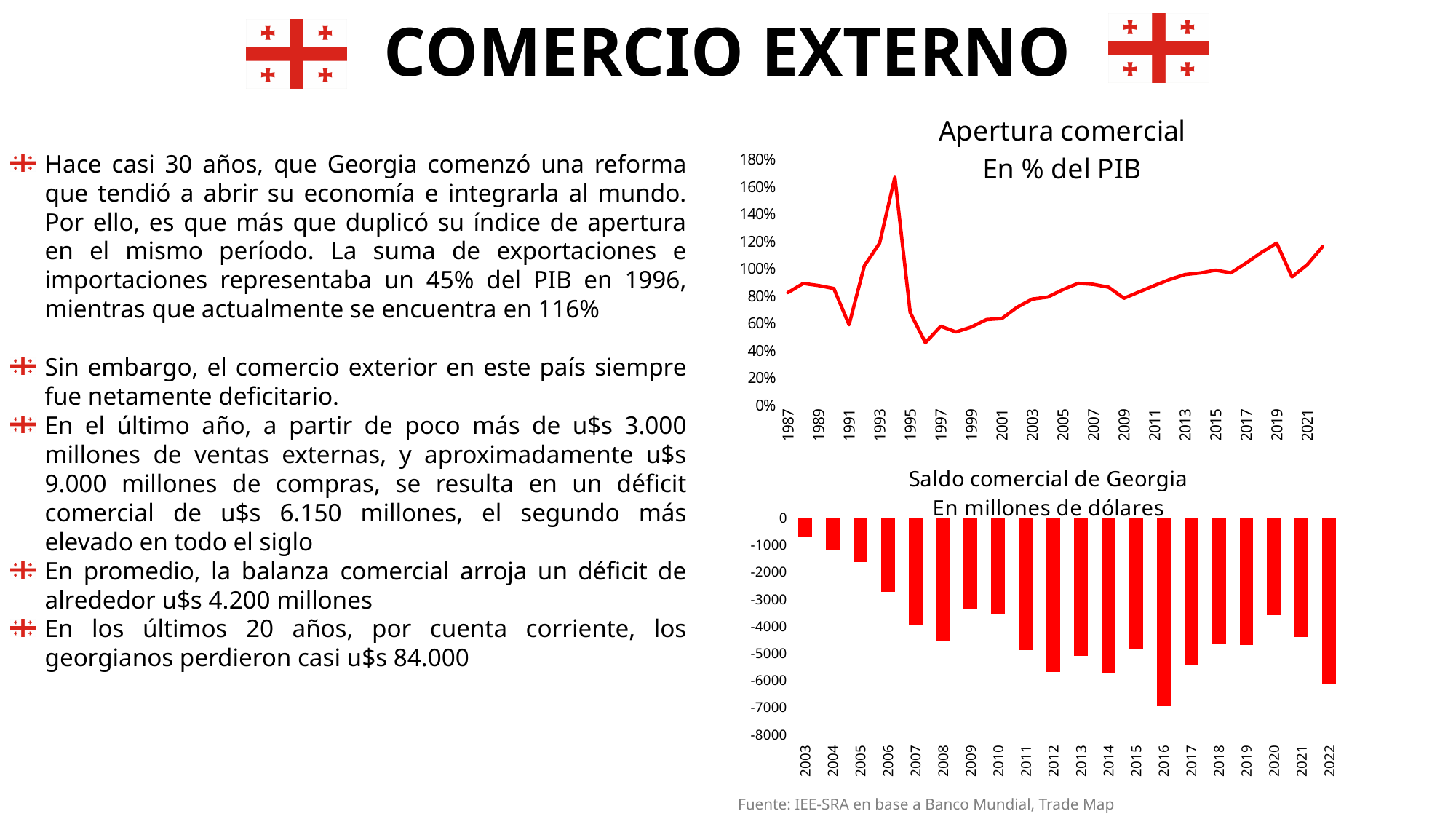
In the 'Apertura comercial' chart, in which year does the line reach its highest value? 1994 In the 'Saldo comercial de Georgia' chart, is the value for 2016 greater or less than -6000? less In the 'Apertura comercial' chart, is the value for 2019 greater or less than 100%? greater In the 'Apertura comercial' chart, is the value for 1996 greater or less than 60%? less What unit is stated in the subtitle of the 'Saldo comercial de Georgia' chart? En millones de dólares In the 'Saldo comercial de Georgia' chart, which year has the smallest deficit (the bar closest to zero)? 2003 What kind of chart is the 'Apertura comercial' chart at the top right? line chart In the 'Saldo comercial de Georgia' chart, which year has the largest deficit (the lowest bar)? 2016 In the 'Saldo comercial de Georgia' chart, how many years (bars) are shown? 20 What kind of chart is the 'Saldo comercial de Georgia' chart at the bottom right? bar chart In the 'Apertura comercial' chart, is the value for 2019 larger or smaller than the value for 2020? larger